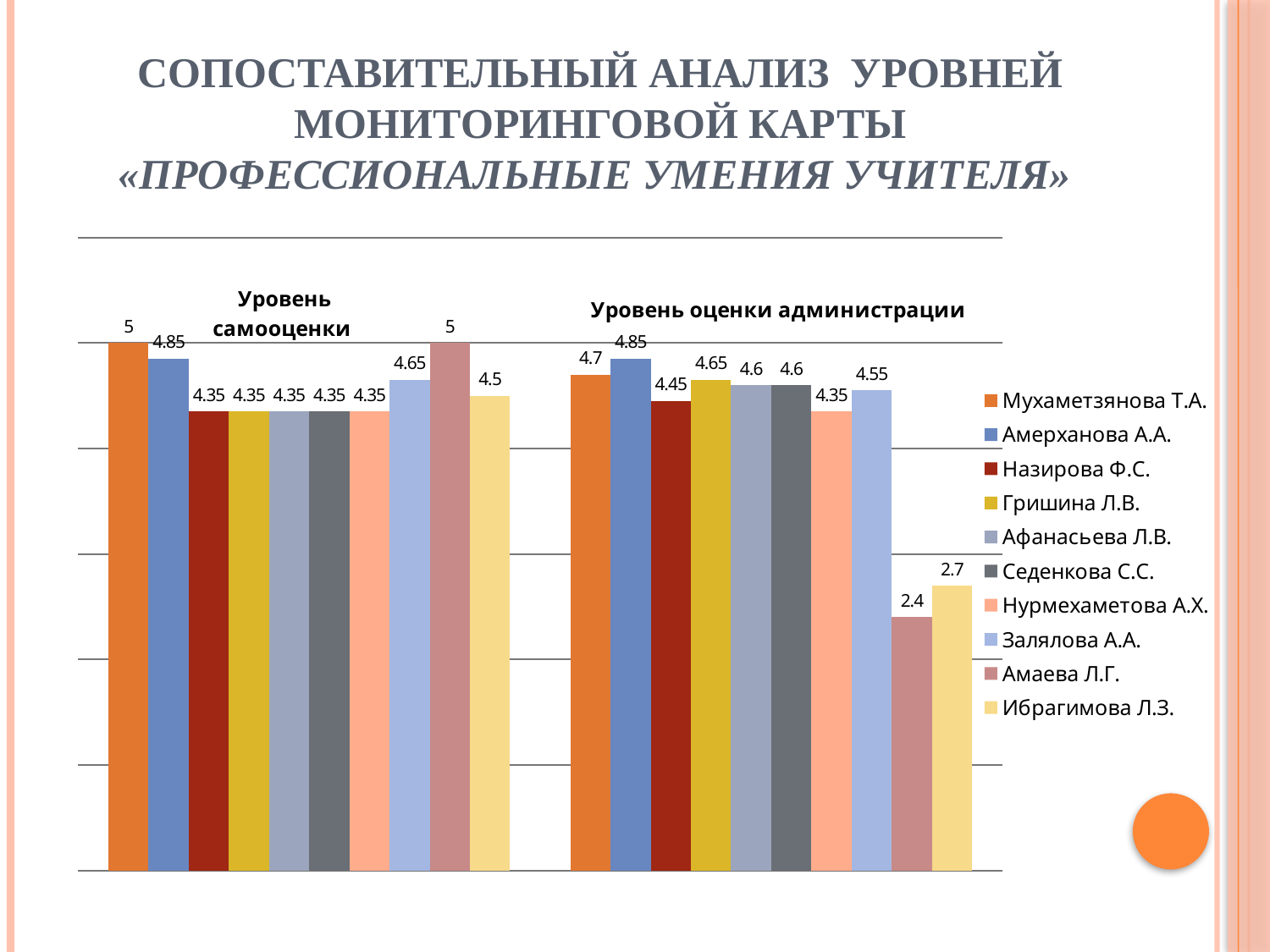
What is the value for Залялова А.А. in the Уровень самооценки category? 4.65 What is the difference between the Уровень самооценки and Уровень оценки администрации values for Амаева Л.Г.? 2.6 What kind of chart is shown on the slide? Bar chart Which is larger for Ибрагимова Л.З.: the Уровень самооценки value or the Уровень оценки администрации value? Уровень самооценки What is the difference between the Уровень самооценки and Уровень оценки администрации values for Мухаметзянова Т.А.? 0.3 What is the value for Гришина Л.В. in the Уровень оценки администрации category? 4.65 What is the value for Ибрагимова Л.З. in the Уровень оценки администрации category? 2.7 What is the value for Мухаметзянова Т.А. in the Уровень самооценки category? 5 How many categories are shown on the x axis? 2 What is the value for Амаева Л.Г. in the Уровень оценки администрации category? 2.4 Which series has the lowest value in the Уровень оценки администрации category? Амаева Л.Г. How many series does the legend list? 10